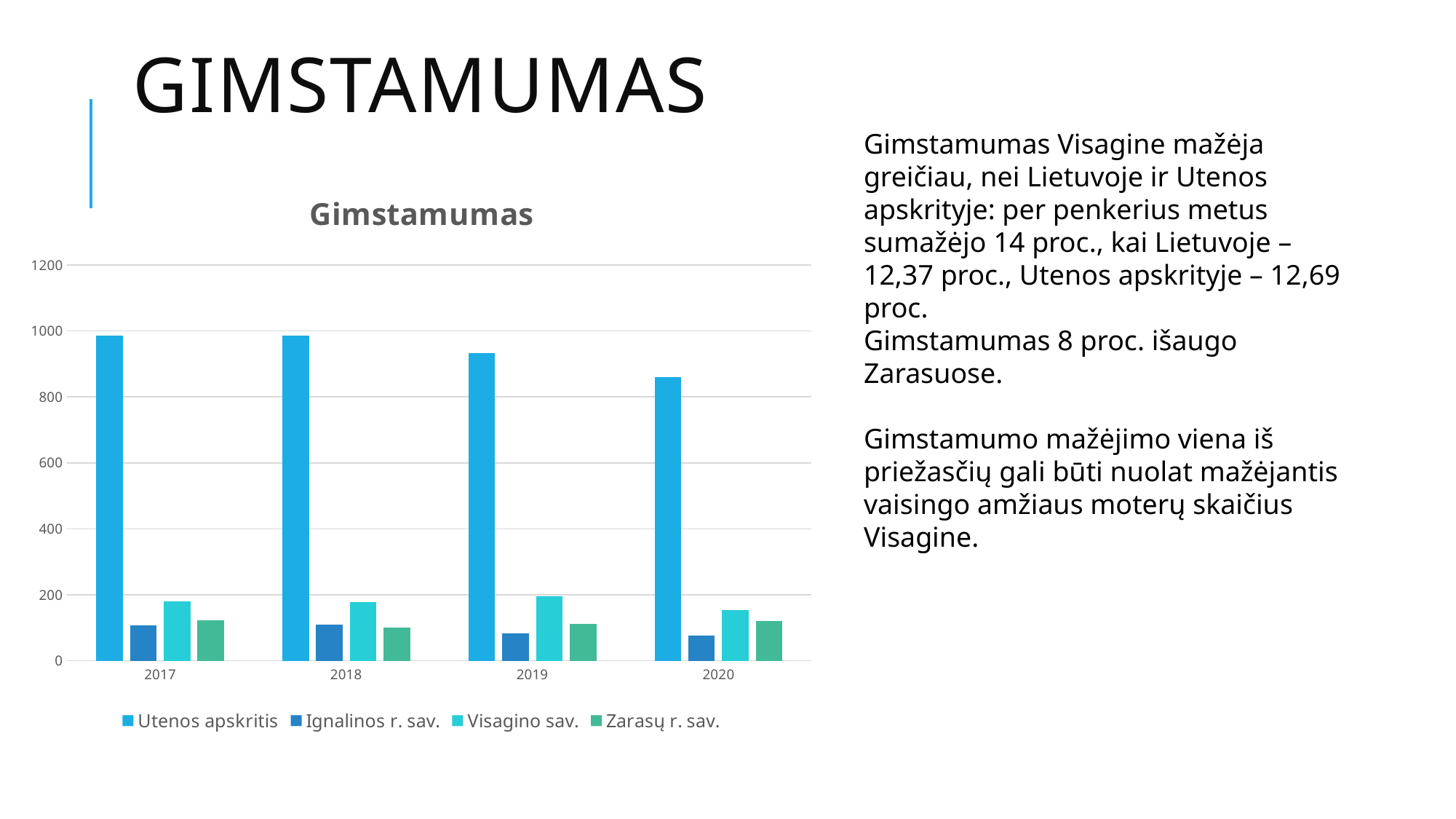
In 2019, which is larger: Visagino sav. or Zarasų r. sav.? Visagino sav. Which series has the lowest value in 2019? Ignalinos r. sav. Do the values for Utenos apskritis rise or fall from 2018 to 2020? fall Is the value for Utenos apskritis in 2019 greater or less than 800? greater How many years are shown on the x axis of the chart? 4 What kind of chart is shown on the slide? bar chart For Ignalinos r. sav., which year has the larger value: 2017 or 2020? 2017 Is the value for Visagino sav. in 2020 greater or less than 200? less What is the title of the chart? Gimstamumas Is the value for Utenos apskritis in 2020 greater or less than 1000? less Which series has the highest value in 2017? Utenos apskritis How many series does the legend of the chart list? 4